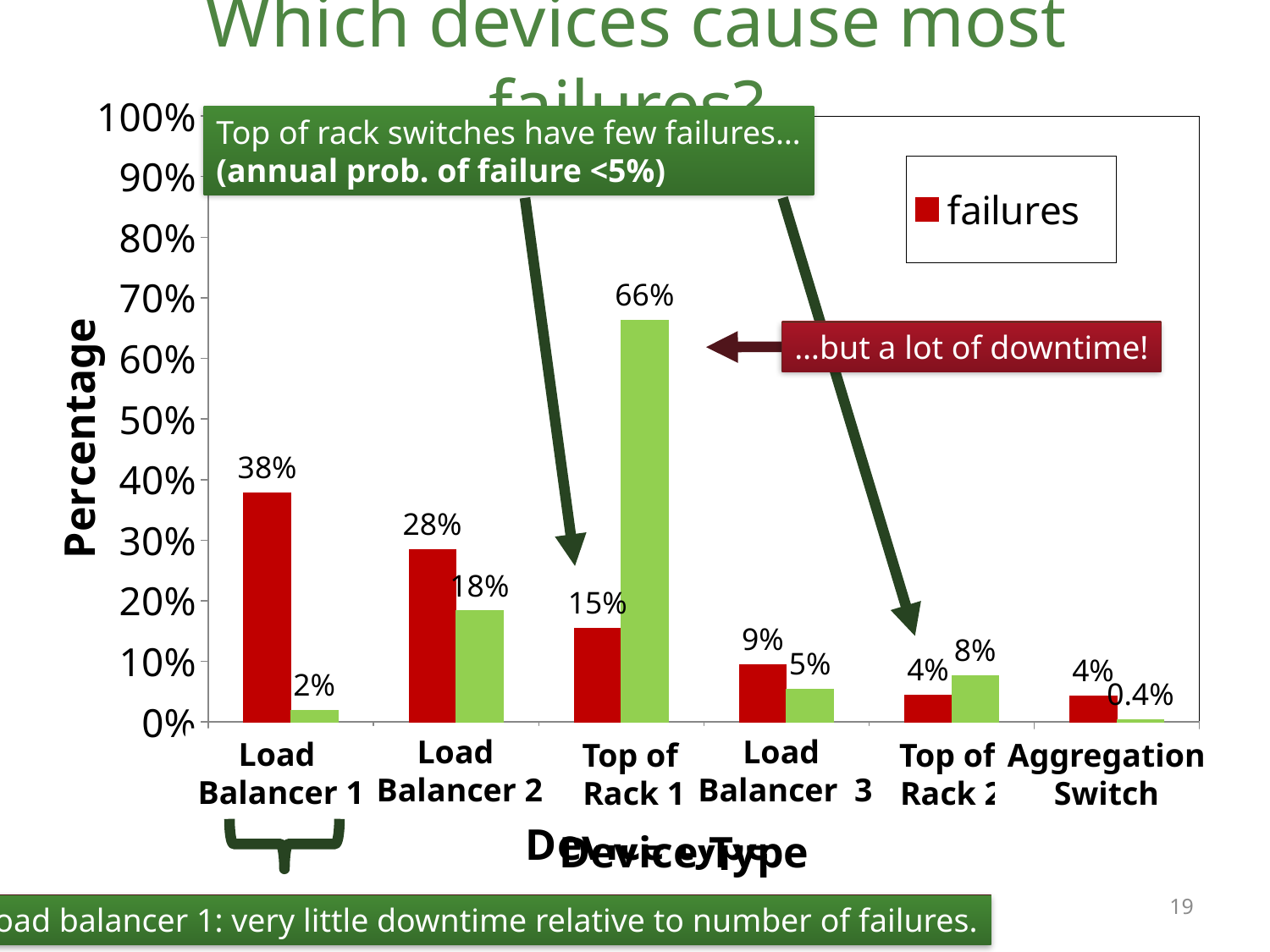
Which device type has the lowest green bar? Aggregation Switch What is the failures value for Load Balancer 1? 38% For Top of Rack 1, which is larger: the failures bar or the green bar? the green bar Do the failures values rise or fall from Load Balancer 1 to Aggregation Switch? fall What is the value of the green bar for Aggregation Switch? 0.4% What is the value of the green bar for Top of Rack 1? 66% Is the failures value for Load Balancer 3 greater or less than 10%? less Which device type has the highest green bar? Top of Rack 1 What is the difference between the failures value and the green bar value for Load Balancer 2? 10 percentage points How many device types are shown on the x axis? 6 Which device type has the highest failures value? Load Balancer 1 What kind of chart is shown on the slide? bar chart